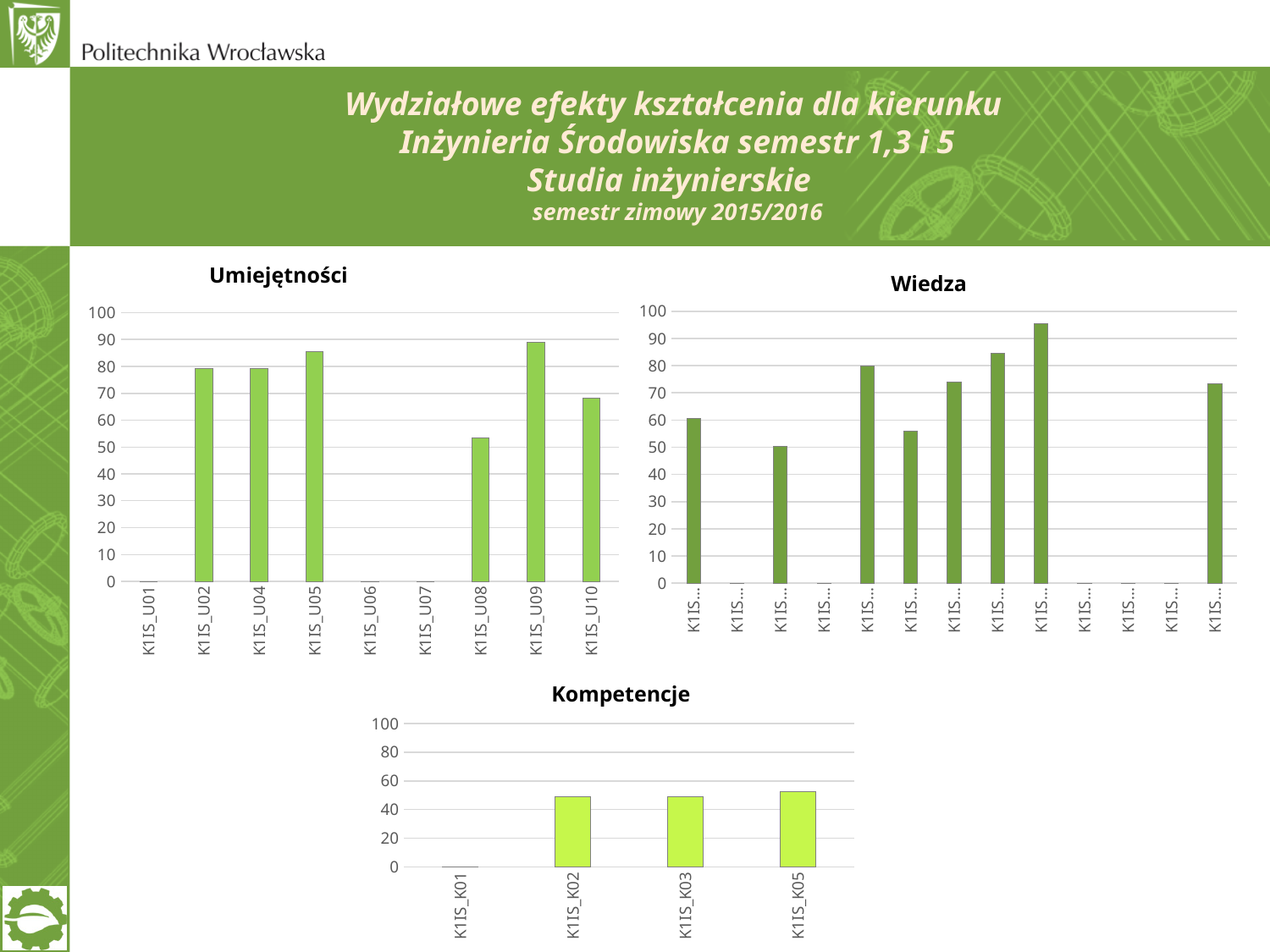
How many categories are shown on the x axis of the 'Kompetencje' chart? 4 In the 'Umiejętności' chart, which category has the highest value? K1IS_U09 In the 'Umiejętności' chart, is the value for K1IS_U05 greater or less than 80? greater What is the title of the chart at the bottom of the slide? Kompetencje In the 'Kompetencje' chart, is the value for K1IS_K02 greater or less than 40? greater What kind of chart is the 'Wiedza' chart? bar chart In the 'Umiejętności' chart, is the value for K1IS_U08 greater or less than 60? less What kind of chart is the 'Umiejętności' chart? bar chart How many bars (categories) are shown on the x axis of the 'Wiedza' chart? 13 How many categories are shown on the x axis of the 'Umiejętności' chart? 9 In the 'Umiejętności' chart, which is larger, the value for K1IS_U09 or K1IS_U10? K1IS_U09 In the 'Umiejętności' chart, what is the value for K1IS_U01? 0